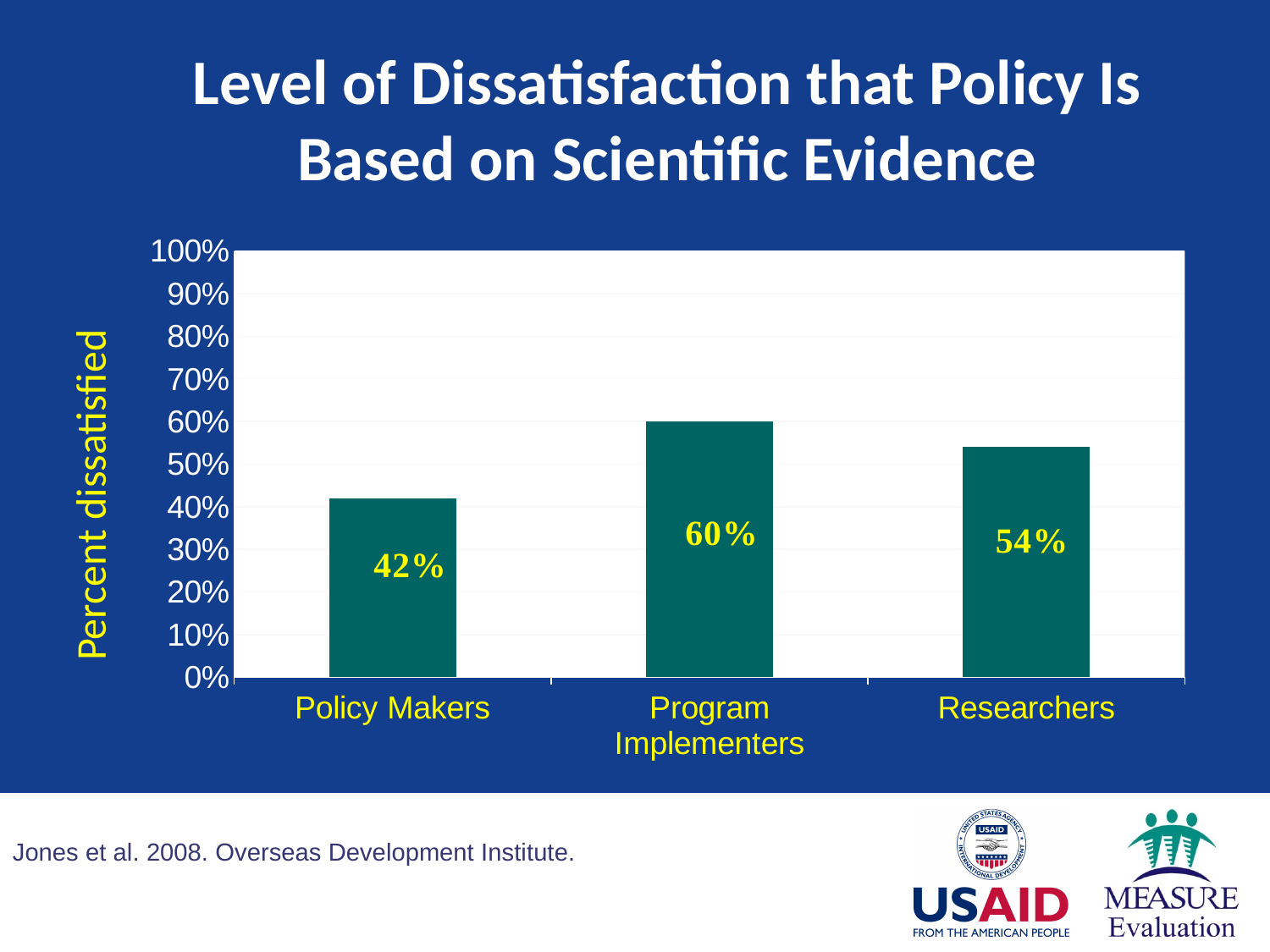
Which group has the lowest level of dissatisfaction? Policy Makers What is the difference in percent dissatisfied between Program Implementers and Policy Makers? 18% How many groups are shown in the chart? 3 What is the percent dissatisfied for Policy Makers? 42% What is the percent dissatisfied for Program Implementers? 60% Which group has the highest level of dissatisfaction? Program Implementers Which group has a higher percent dissatisfied, Researchers or Policy Makers? Researchers What is the label of the vertical axis? Percent dissatisfied Is the value for Researchers greater or less than 50%? greater What is the difference in percent dissatisfied between Researchers and Policy Makers? 12% What kind of chart is shown on the slide? Bar chart What is the percent dissatisfied for Researchers? 54%